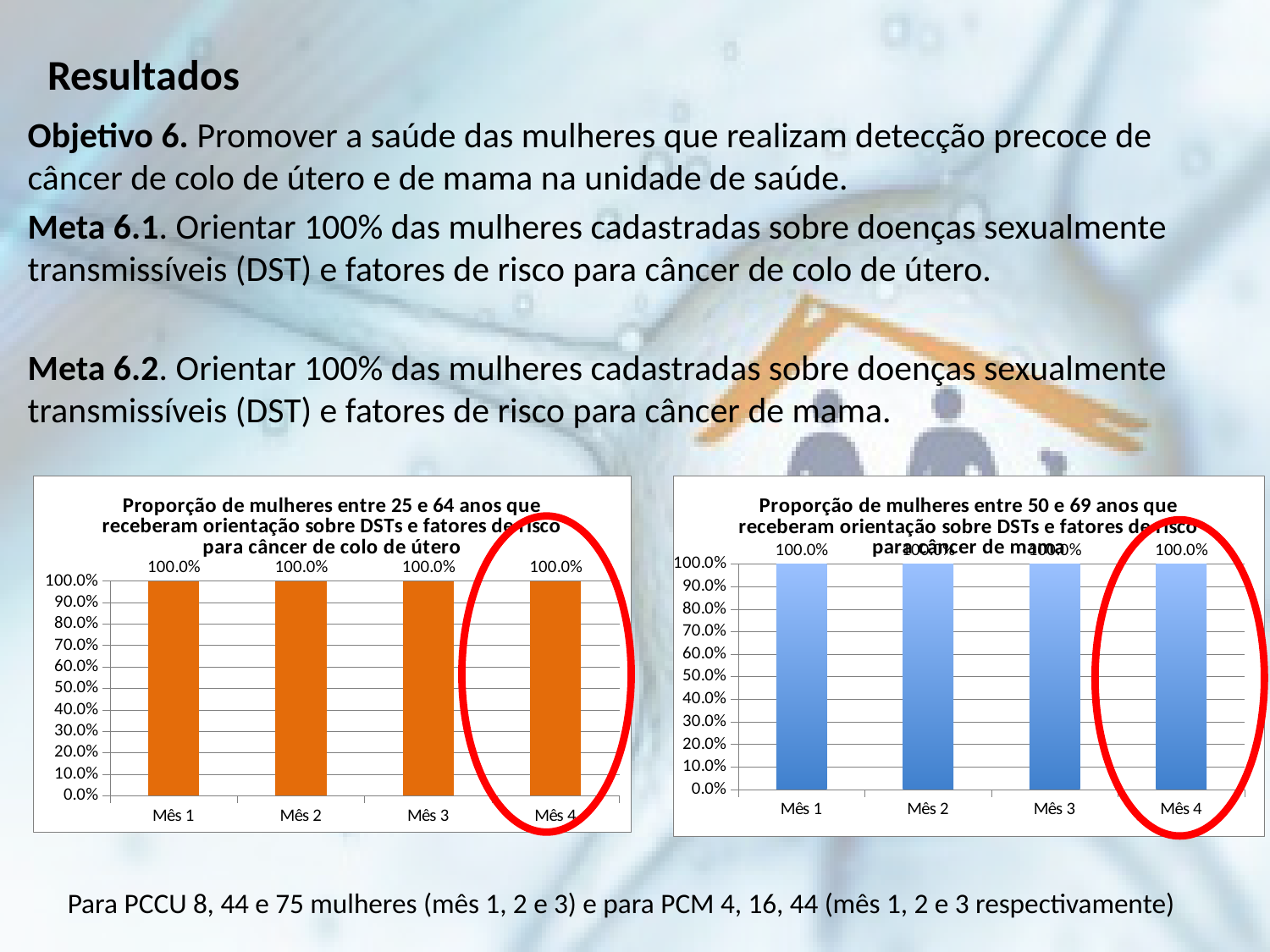
Which age range of women does the right chart's title refer to? 50 to 69 years What kind of chart is the left chart (women aged 25 to 64)? Bar chart How many categories (months) are shown on the x axis of the left chart? 4 In the left chart, what is the difference between the values for Mês 3 and Mês 1? 0.0% In the left chart (women aged 25 to 64), what is the value for Mês 4? 100.0% How many bars are plotted in the right chart (women aged 50 to 69)? 4 In the right chart, is the value for Mês 3 greater or less than 90.0%? greater In the right chart (women aged 50 to 69), what is the value for Mês 4? 100.0% In the right chart, do the values rise, fall, or stay the same from Mês 1 to Mês 4? Stay the same What colour are the bars in the left chart (women aged 25 to 64)? Orange In the right chart (women aged 50 to 69), what is the value for Mês 2? 100.0% In the left chart (women aged 25 to 64), what is the value for Mês 1? 100.0%